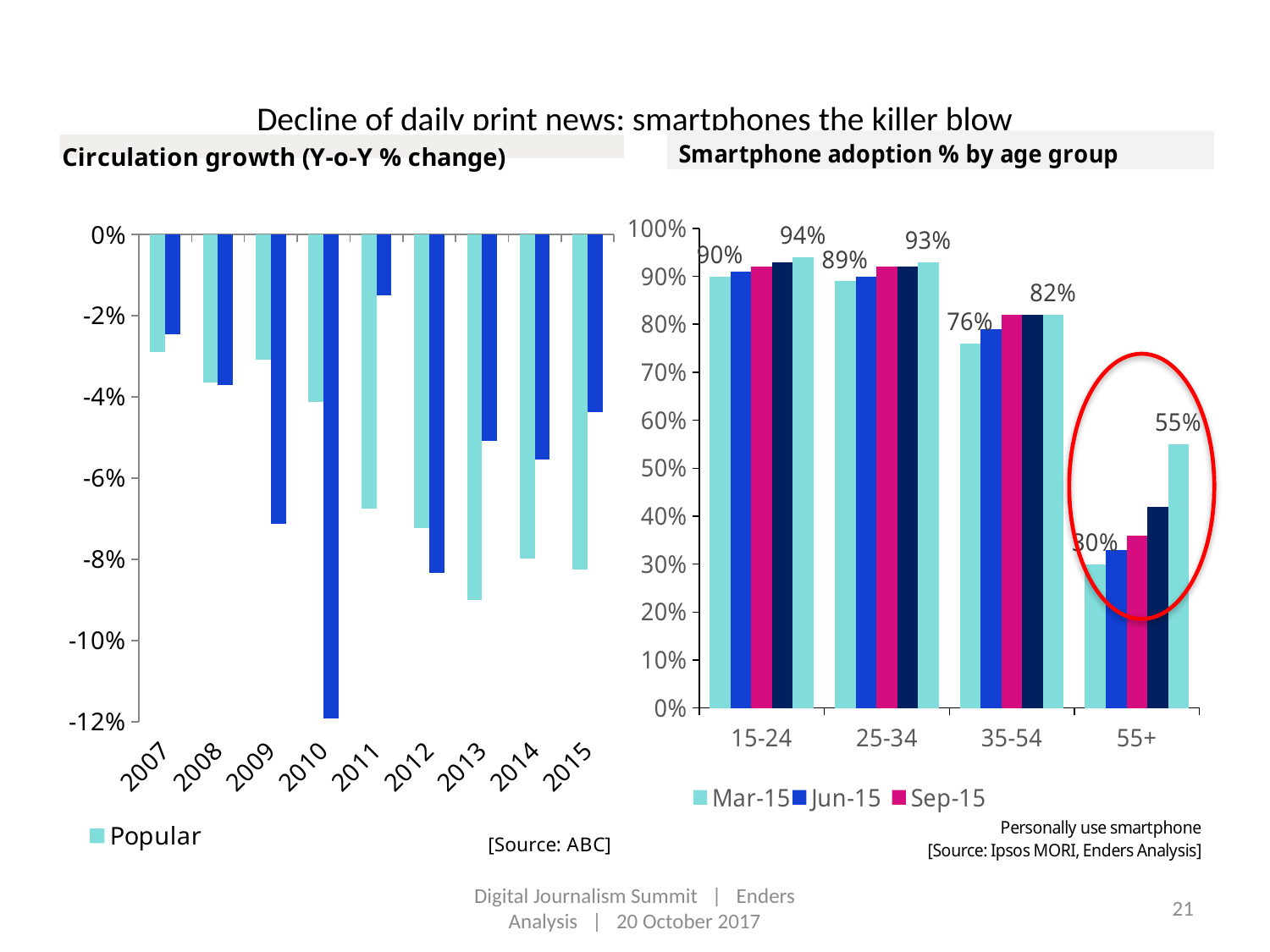
On the 'Smartphone adoption % by age group' chart, which age group has the lowest Mar-15 adoption? 55+ How many series does the legend of the 'Smartphone adoption % by age group' chart list? 3 On the 'Smartphone adoption % by age group' chart, what is the Mar-15 value for the 55+ age group? 30% How many age groups are shown on the 'Smartphone adoption % by age group' chart? 4 On the 'Smartphone adoption % by age group' chart, what is the Mar-15 value for the 35-54 age group? 76% What kind of chart is the 'Smartphone adoption % by age group' chart? bar chart On the 'Circulation growth (Y-o-Y % change)' chart, is the Popular value for 2013 above or below -8%? below On the 'Smartphone adoption % by age group' chart, what is the Mar-15 value for the 15-24 age group? 90% On the 'Circulation growth (Y-o-Y % change)' chart, which year has the lowest Popular value? 2013 On the 'Smartphone adoption % by age group' chart, which age group has the highest Mar-15 adoption? 15-24 How many years are shown on the 'Circulation growth (Y-o-Y % change)' chart? 9 On the 'Smartphone adoption % by age group' chart, what is the difference between the Mar-15 values for 15-24 and 55+? 60 percentage points